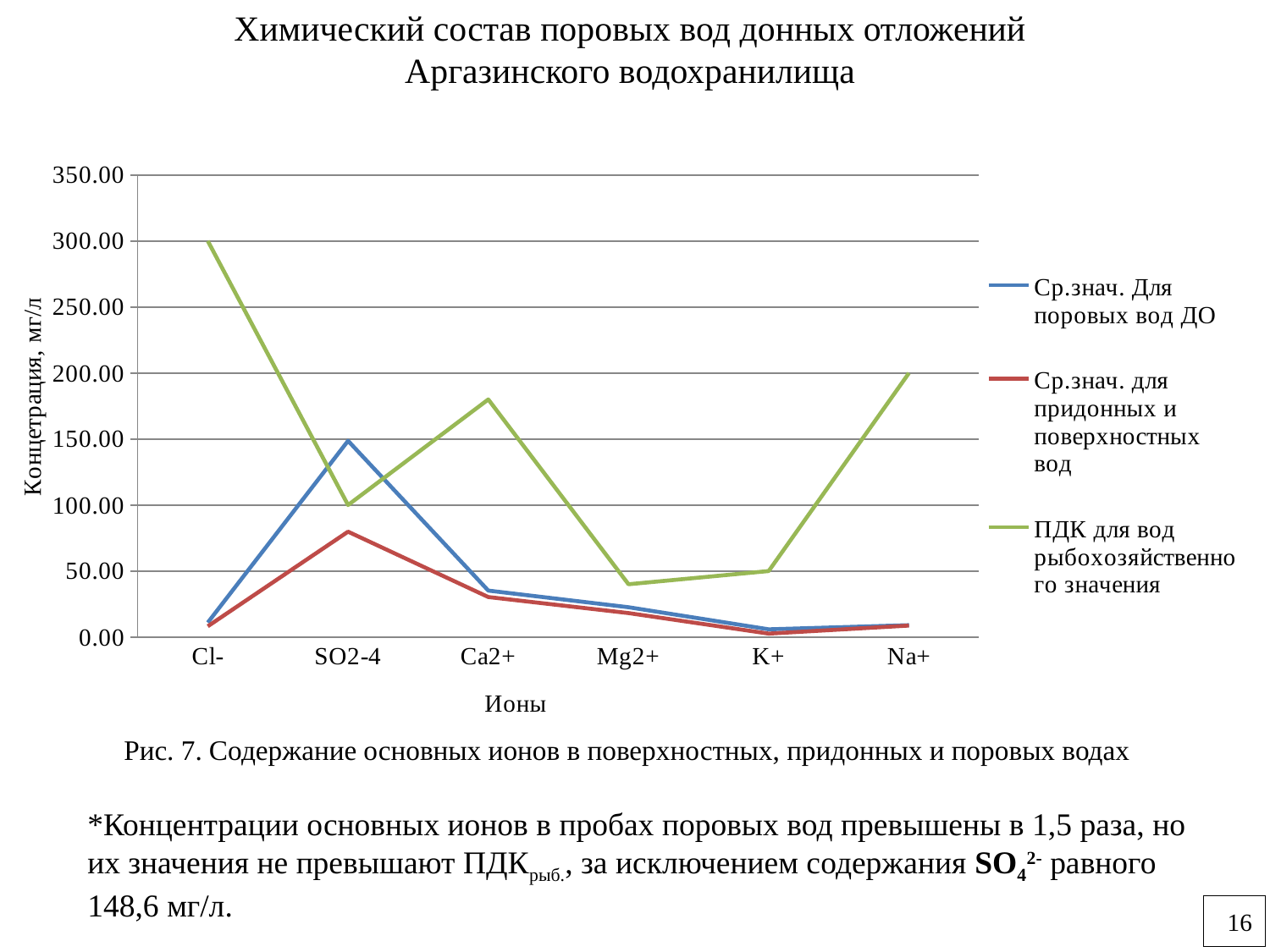
At SO2-4, which series has the larger value: 'Ср.знач. Для поровых вод ДО' or 'Ср.знач. для придонных и поверхностных вод'? Ср.знач. Для поровых вод ДО For which ion is the value of the series 'ПДК для вод рыбохозяйственного значения' lowest? Mg2+ For which ion is the value of the series 'Ср.знач. Для поровых вод ДО' highest? SO2-4 How many ion categories are shown on the x axis? 6 How many series does the legend list? 3 For which ion is the value of the series 'ПДК для вод рыбохозяйственного значения' highest? Cl- Does the 'ПДК для вод рыбохозяйственного значения' line rise or fall from Mg2+ to Na+? rise What kind of chart is shown on the slide? line chart Is the value of 'Ср.знач. для придонных и поверхностных вод' for SO2-4 greater or less than 100.00? less What is the title of the y axis? Концентрация, мг/л Is the value of 'ПДК для вод рыбохозяйственного значения' for Ca2+ greater or less than 150.00? greater Is the value of 'Ср.знач. Для поровых вод ДО' for SO2-4 greater or less than 100.00? greater